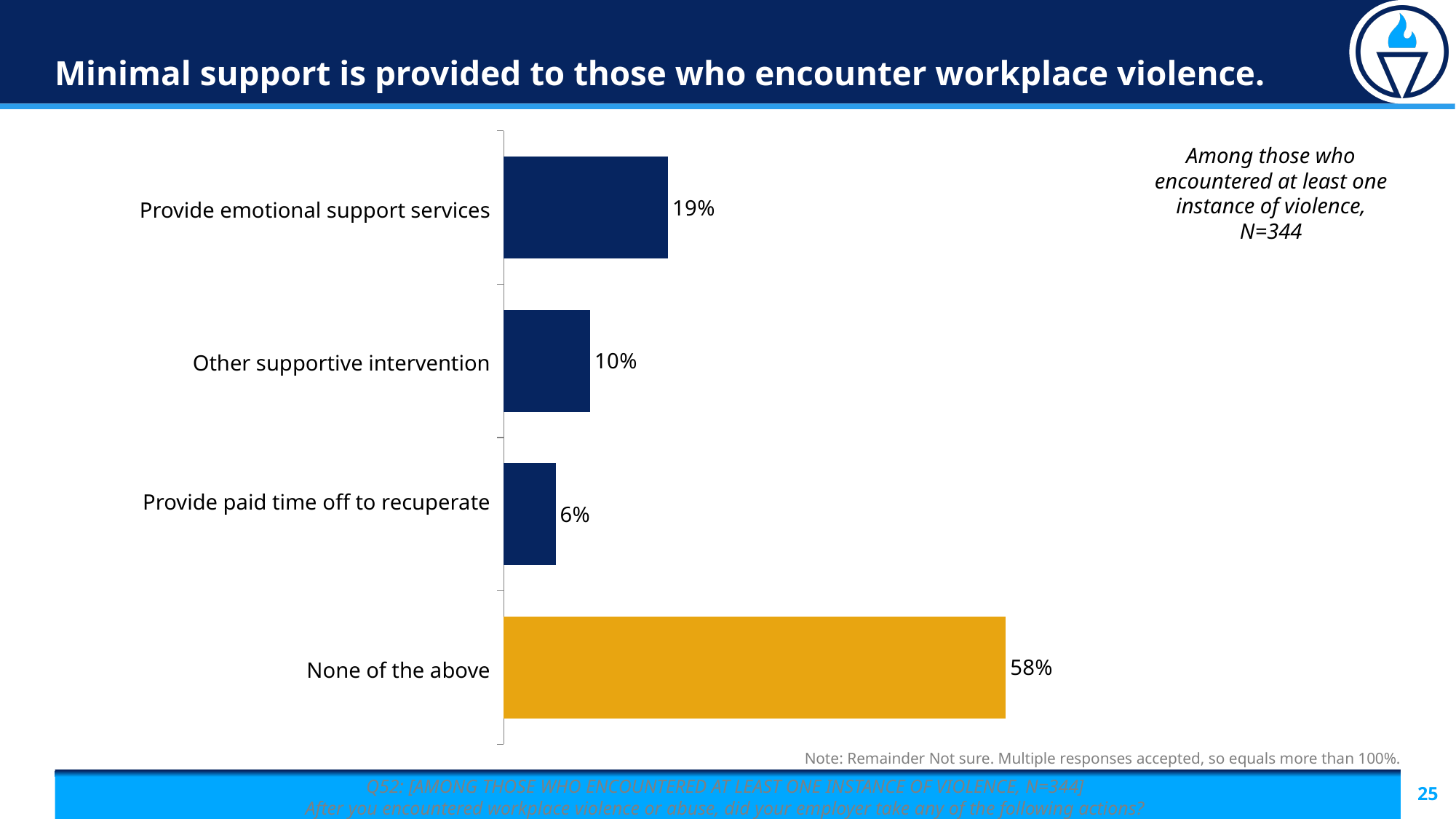
Which is larger: the value for "Other supportive intervention" or the value for "Provide paid time off to recuperate"? Other supportive intervention Which bar is coloured differently (gold) from the others? None of the above What is the difference between the values for "Provide emotional support services" and "Provide paid time off to recuperate"? 13 percentage points What is the difference between the values for "None of the above" and "Provide emotional support services"? 39 percentage points Which category has the lowest value in the chart? Provide paid time off to recuperate What is the value shown for "None of the above"? 58% What is the value shown for "Other supportive intervention"? 10% What percentage of respondents said their employer provided paid time off to recuperate? 6% What kind of chart is shown on the slide? Bar chart What percentage of respondents said their employer provided emotional support services? 19% How many categories are shown in the chart? 4 Which category has the highest value in the chart? None of the above